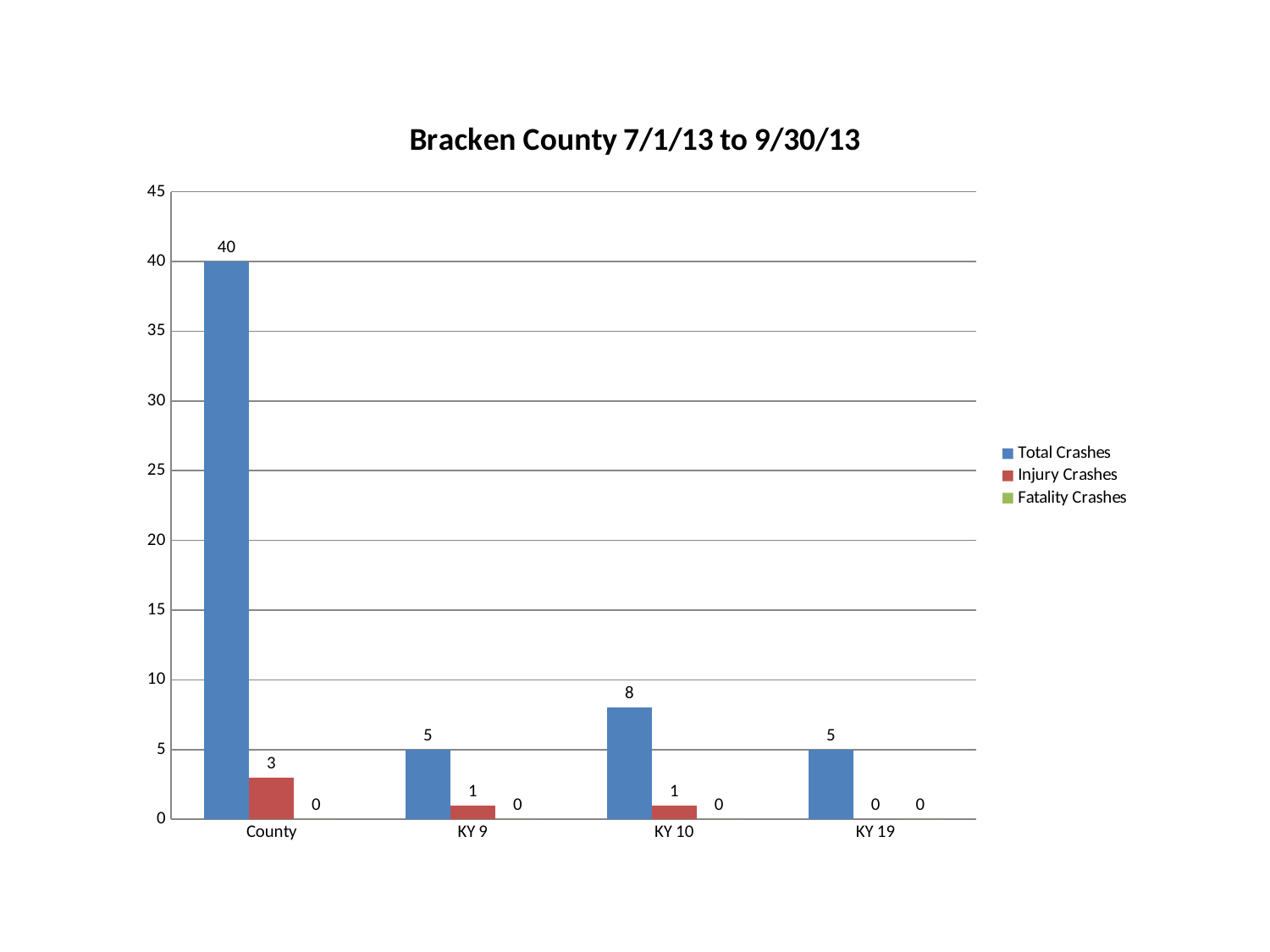
What kind of chart is shown on the slide? bar chart Is the value of Total Crashes for County greater or less than 35? greater What is the value of Injury Crashes for KY 10? 1 How many series does the legend list? 3 What is the title of the chart? Bracken County 7/1/13 to 9/30/13 What is the value of Total Crashes for County? 40 What is the difference between Total Crashes for County and Total Crashes for KY 10? 32 How many categories are shown on the x axis? 4 Which is larger: Total Crashes for KY 10 or Total Crashes for KY 9? KY 10 Which category has the highest Total Crashes value? County What is the value of Fatality Crashes for KY 19? 0 Which category has the highest Injury Crashes value? County